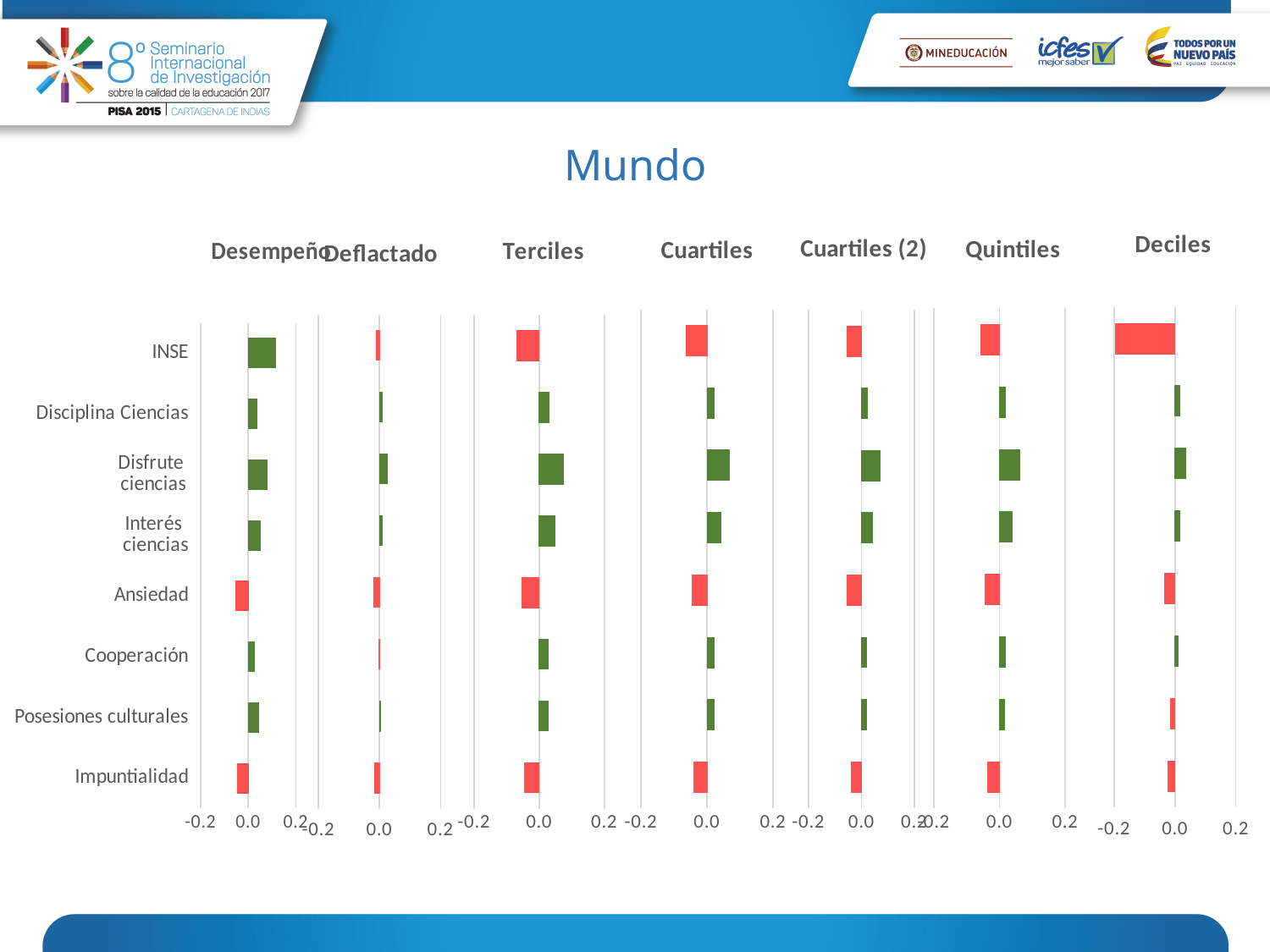
How many separate chart panels are shown on the slide? 7 How many categories are listed on the vertical axis of the Terciles chart? 8 In the Deciles chart, is the value for INSE greater or less than 0.0? less In the Cuartiles chart, is the value for Disfrute ciencias greater or less than 0.0? greater In the Quintiles chart, is the value for Impuntialidad greater or less than 0.0? less In the Deciles chart, which category has the lowest value? INSE In the Desempeño chart, which category has the highest value? INSE What is the title shown above the set of charts on the slide? Mundo What kind of chart is used for the Desempeño panel? bar chart In the Deciles chart, which is larger, the value for INSE or the value for Disfrute ciencias? Disfrute ciencias